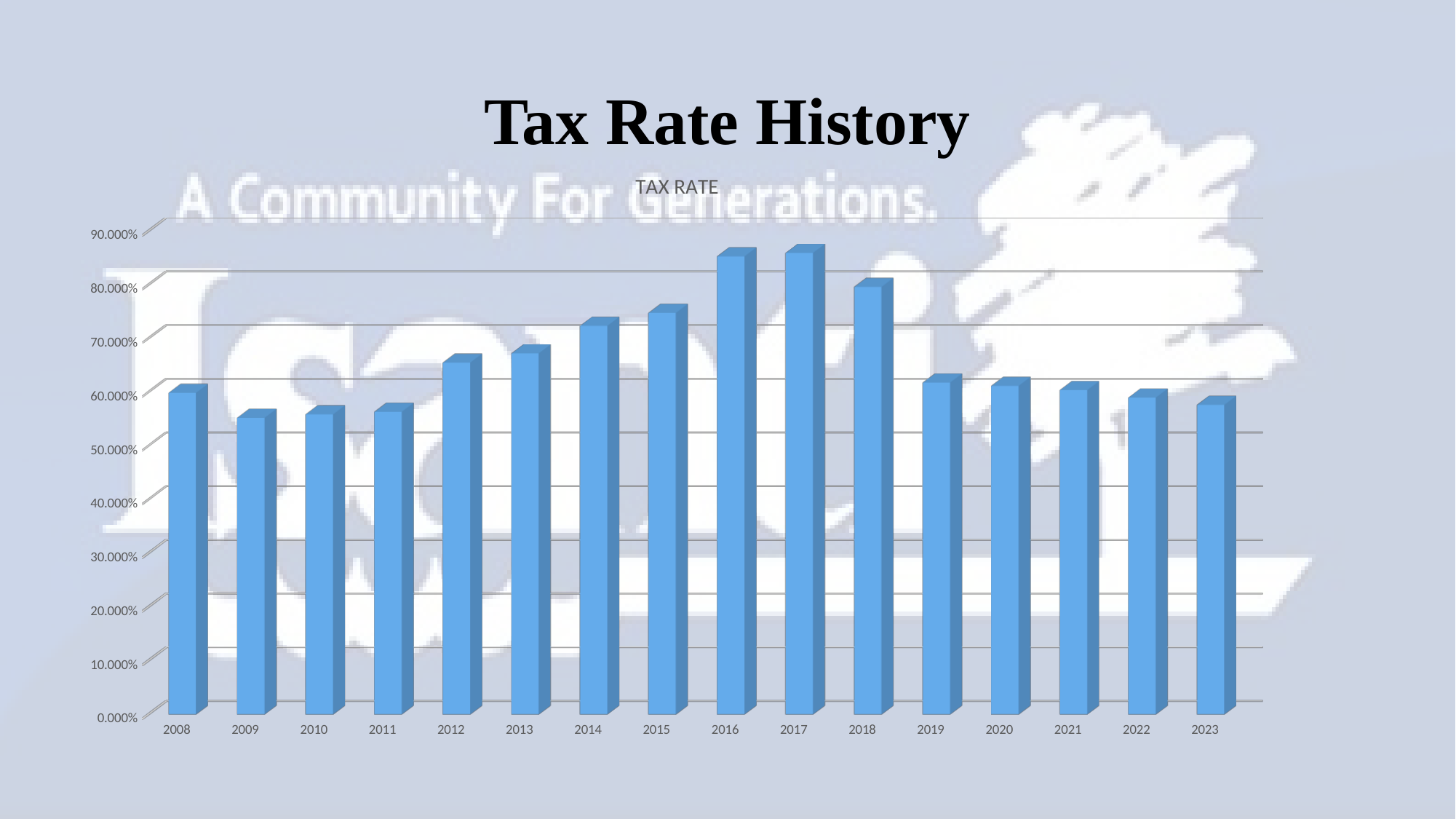
Do the tax rates rise or fall from 2017 to 2023? fall Which year has the higher tax rate, 2018 or 2019? 2018 Is the tax rate for 2014 greater or less than 70.000%? greater Is the tax rate for 2009 greater or less than 60.000%? less Do the tax rates rise or fall from 2011 to 2016? rise What is the title printed above the chart's plot area? TAX RATE Is the tax rate for 2016 greater or less than 80.000%? greater Which year has the higher tax rate, 2013 or 2015? 2015 How many years are plotted on the x axis of the chart? 16 What kind of chart is shown on the slide? bar chart